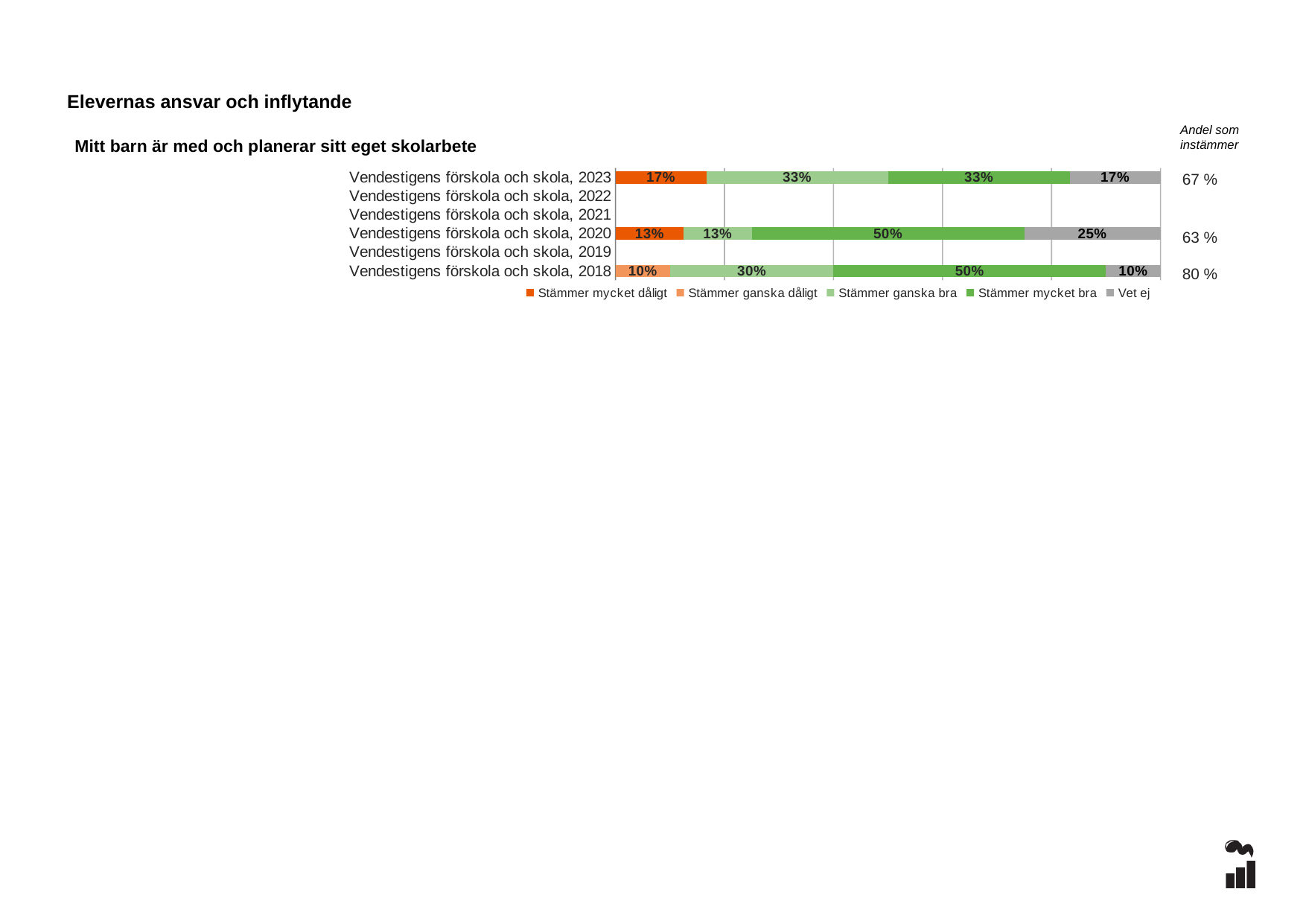
Which year has the highest 'Andel som instämmer' value? 2018 How many category rows (years) are listed on the chart's axis? 6 What is the value for 'Stämmer mycket bra' for Vendestigens förskola och skola, 2020? 50% What is the 'Andel som instämmer' value shown for Vendestigens förskola och skola, 2018? 80 % What is the value for 'Vet ej' for Vendestigens förskola och skola, 2023? 17% What is the value for 'Stämmer ganska dåligt' for Vendestigens förskola och skola, 2018? 10% How many series does the legend list? 5 What is the title of the chart? Mitt barn är med och planerar sitt eget skolarbete Which is larger: 'Stämmer ganska bra' for 2023 or 'Stämmer ganska bra' for 2020? 2023 What type of chart is shown on the slide? Stacked bar chart Which year has the lowest 'Andel som instämmer' value? 2020 What is the difference between the 'Vet ej' values for 2020 and 2018? 15%